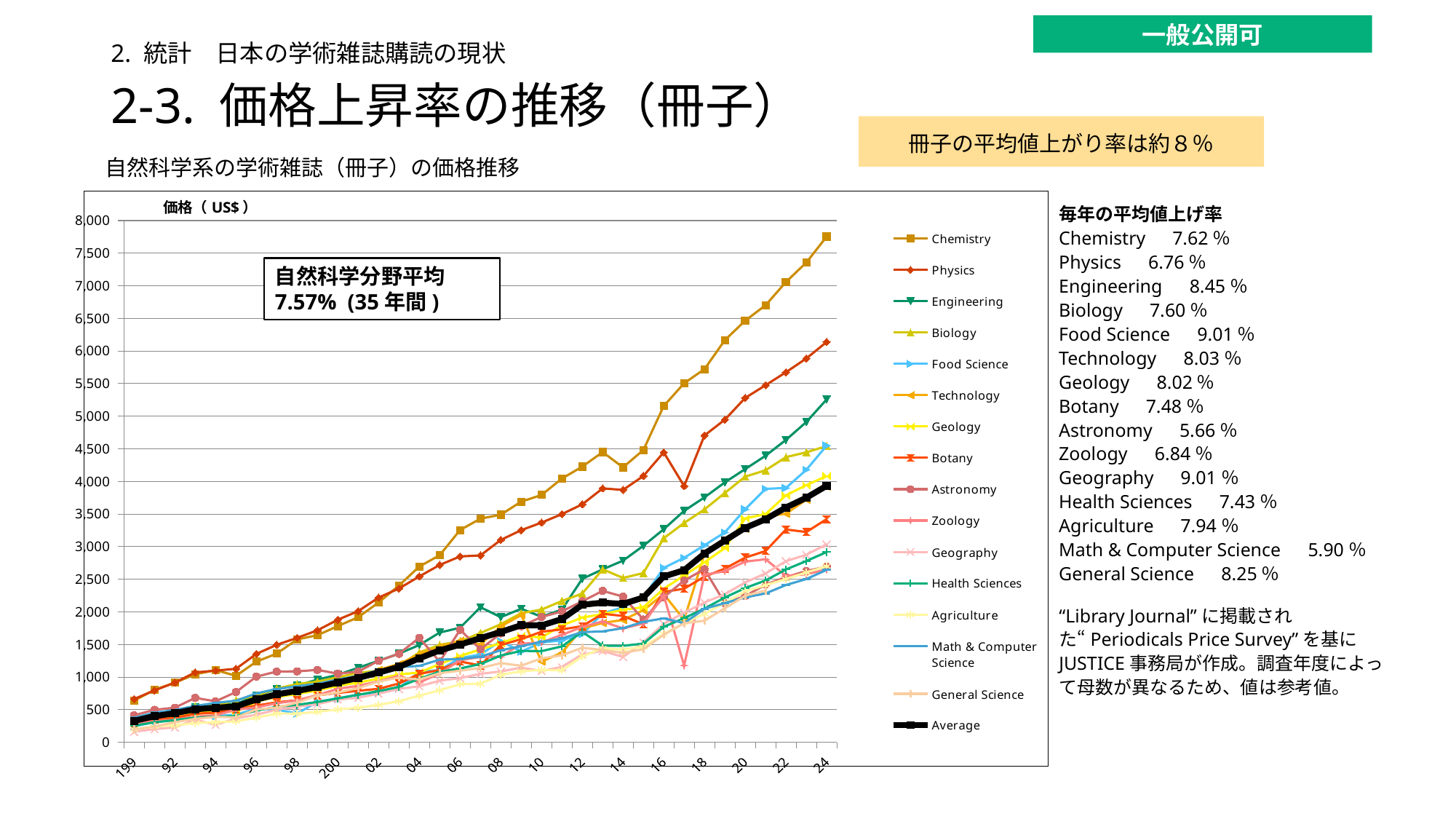
Is the value for Engineering in 2024 greater or less than 5,000? greater What average rate does the text box inside the chart give for the natural science fields over 35 years? 7.57% Is the value for Chemistry in 2024 greater or less than 7,500? greater Which is larger in 2024, the value for Chemistry or the value for Physics? Chemistry Which series has the highest value at the right end of the chart (2024)? Chemistry What is the label of the chart's vertical axis? 価格 ( US$ ) Is the value for Chemistry in 1990 greater or less than 500? greater What kind of chart is shown on the slide? line chart Do the values for the Average series rise or fall from 1990 to 2024? rise How many series does the chart's legend list? 16